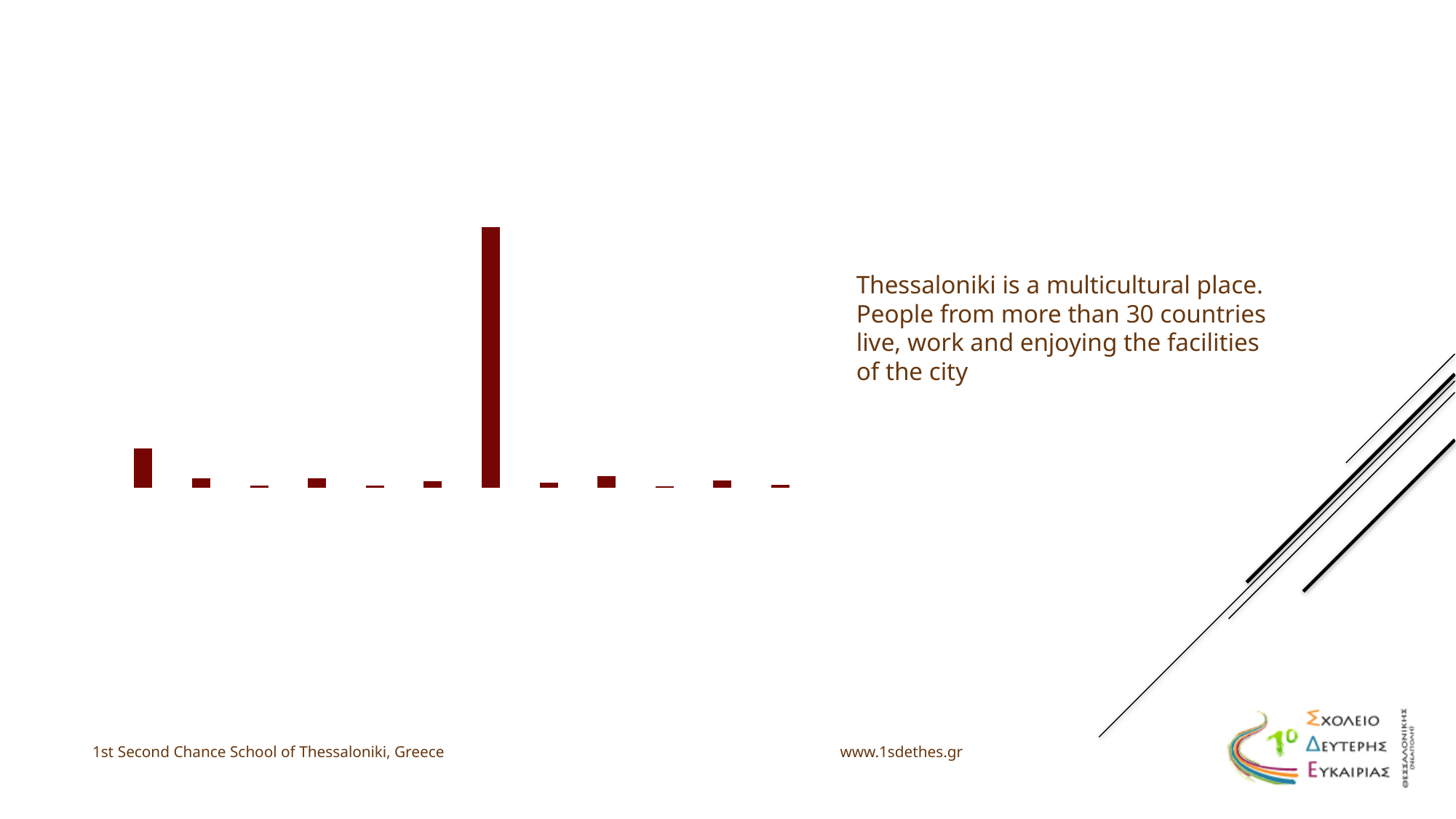
Counting from the left, which bar in the chart is the tallest? the 7th bar Does the chart display a title, axis labels or a legend? No Which is taller in the chart: the 9th bar from the left or the 10th bar from the left? the 9th bar Counting from the left, which bar in the chart is the second tallest? the 1st bar What kind of chart is shown on the left of the slide? bar chart How many bars does the chart contain? 12 Which is taller in the chart: the 2nd bar from the left or the 3rd bar from the left? the 2nd bar Which is taller in the chart: the 1st bar from the left or the 7th bar from the left? the 7th bar What colour are the bars in the chart? dark red